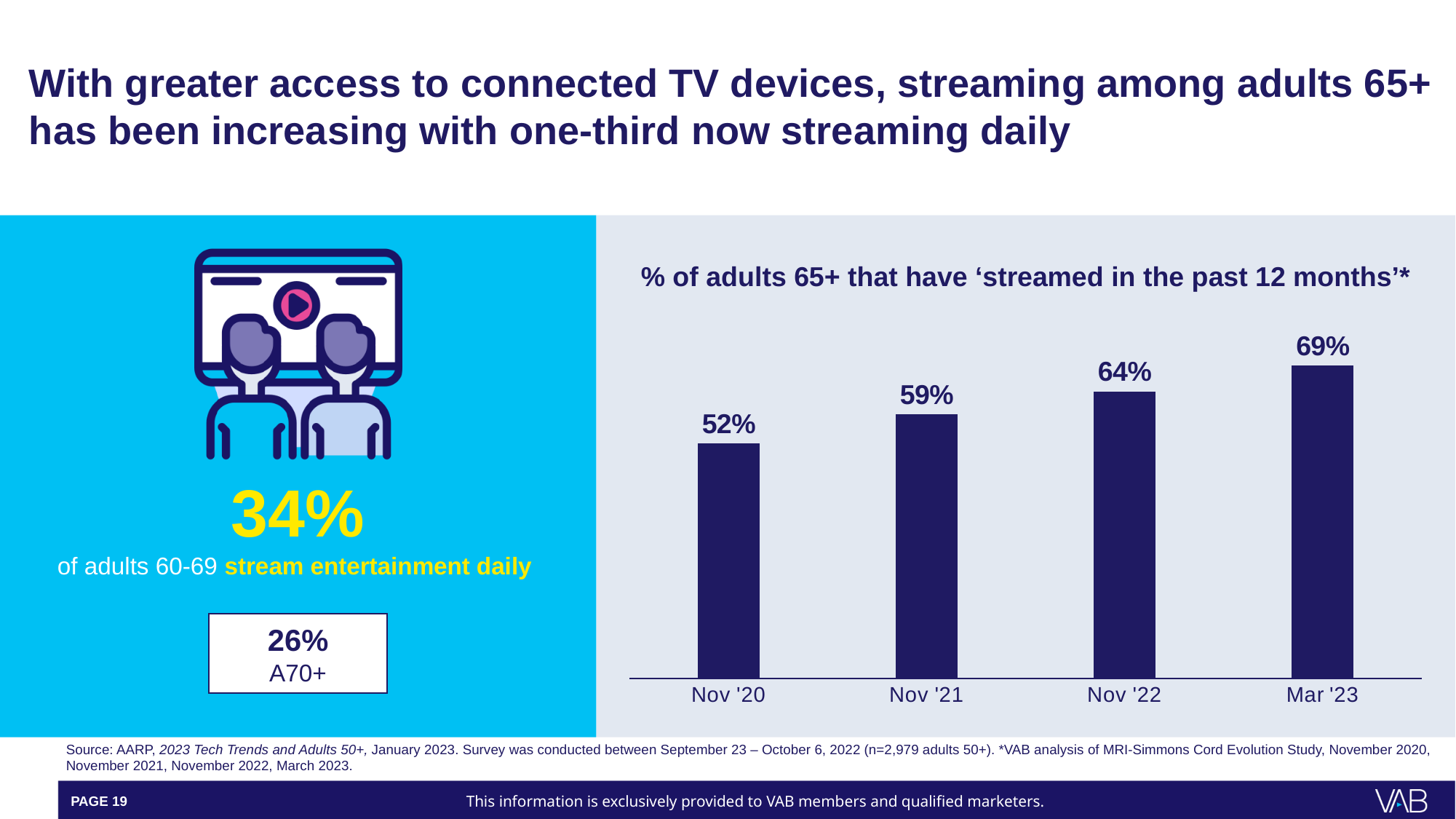
What is the value for Nov '21? 59% What is the difference between the values for Nov '22 and Nov '21? 5 percentage points Do the values rise or fall from Nov '20 to Mar '23? Rise Which period has the lowest value? Nov '20 How many bars are shown in the chart? 4 What kind of chart is shown? Bar chart Which period has the highest value? Mar '23 What is the value for Mar '23? 69% What is the difference between the values for Mar '23 and Nov '20? 17 percentage points What is the value for Nov '20? 52% What is the value for Nov '22? 64% Which is larger, the value for Nov '21 or the value for Nov '22? Nov '22